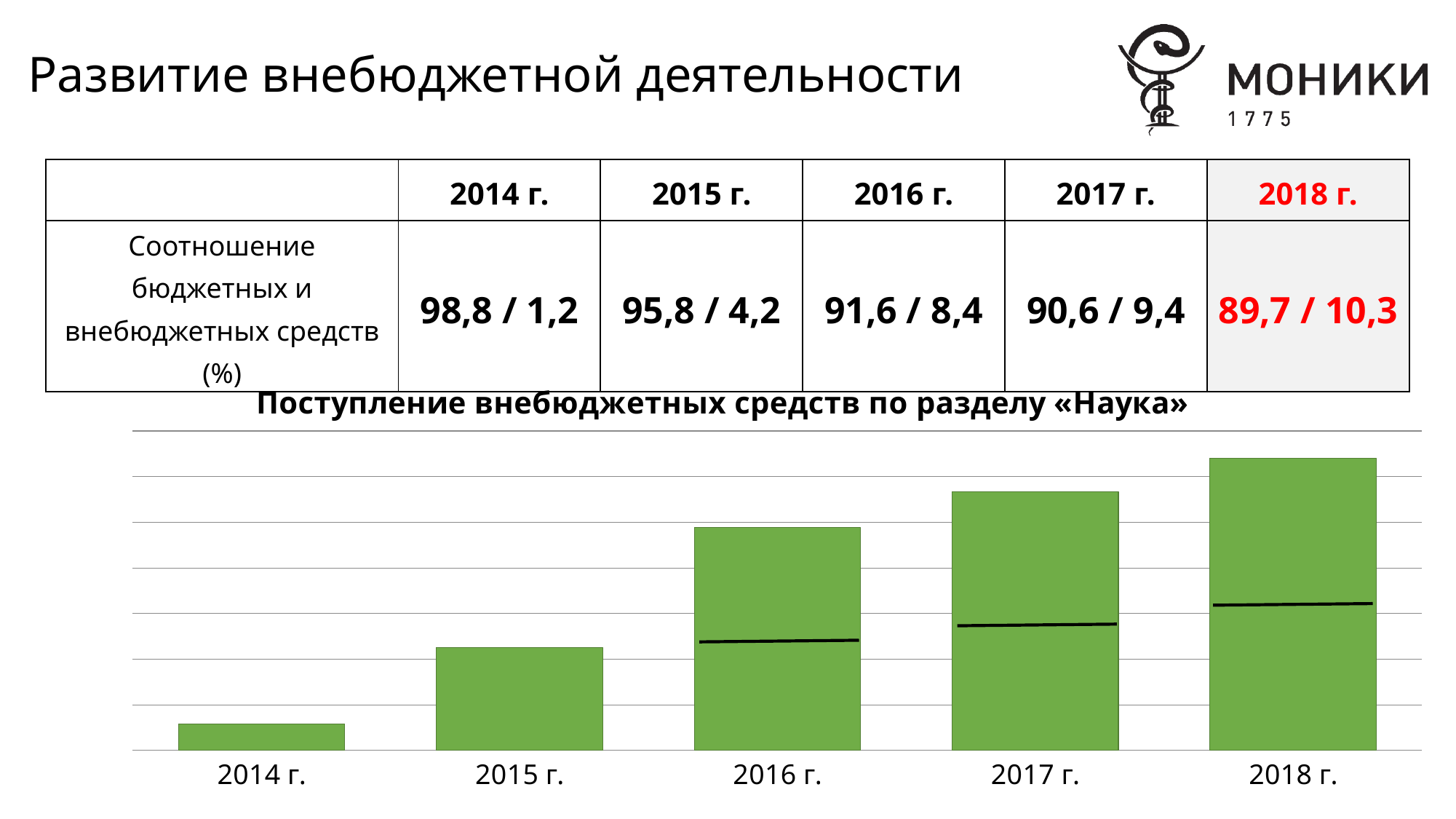
Which bar is shorter, 2014 г. or 2015 г.? 2014 г. Which year has the shortest bar in the chart? 2014 г. What is the title of the bar chart? Поступление внебюджетных средств по разделу «Наука» What colour are the bars in the chart? green Which bar is taller, 2015 г. or 2016 г.? 2016 г. Which year has the tallest bar in the chart? 2018 г. What kind of chart is shown under the title «Поступление внебюджетных средств по разделу «Наука»»? bar chart How many years (categories) are shown on the x axis of the bar chart? 5 Which bar is taller, 2017 г. or 2018 г.? 2018 г. What is the first year shown on the x axis of the chart? 2014 г. Do the bar values rise or fall from 2014 г. to 2018 г.? rise